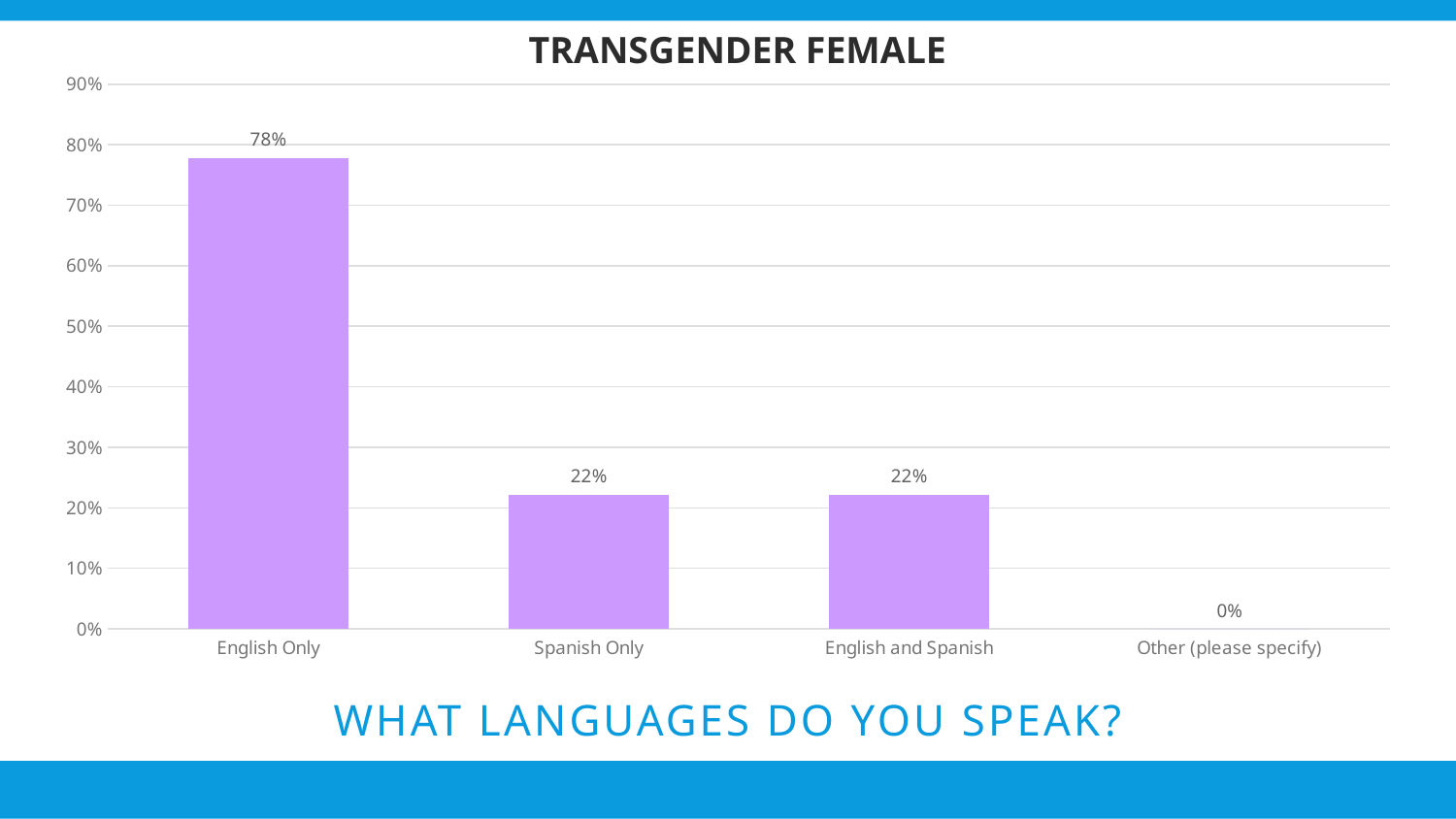
What is the value for English and Spanish? 22% What is the value for Other (please specify)? 0% Which category has the highest value? English Only What is the title of the chart? TRANSGENDER FEMALE What is the value for Spanish Only? 22% What is the value for English Only? 78% Which is larger, the value for English Only or the value for English and Spanish? English Only What kind of chart is shown on the slide? bar chart How many categories are shown on the x axis? 4 What is the difference between the values for English Only and Spanish Only? 56% Which category has the lowest value? Other (please specify) Is the value for English Only greater or less than 70%? greater